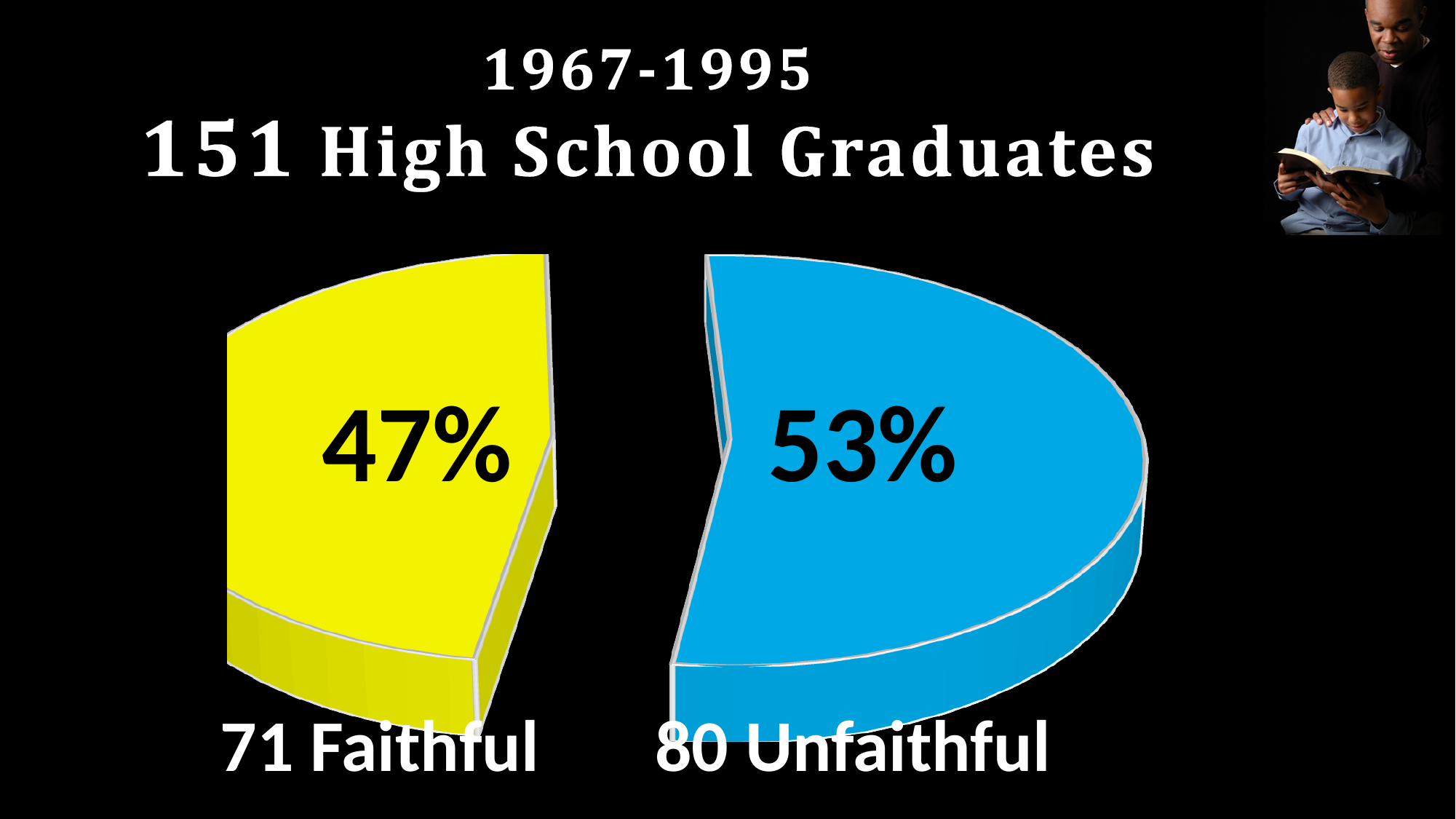
Which slice of the pie is larger, Faithful or Unfaithful? Unfaithful What is the total number of high school graduates stated in the chart title? 151 How many graduates are labelled as Unfaithful? 80 How many slices does the pie chart have? 2 What kind of chart is shown on the slide? Pie chart How many graduates are labelled as Faithful? 71 What is the difference in percentage points between the Unfaithful and Faithful slices? 6 Which category has the smallest share of the pie? Faithful What is the difference between the number of Unfaithful and Faithful graduates? 9 What percentage of the pie is labelled for the Faithful slice? 47% What colour is the Unfaithful slice of the pie? Blue What percentage of the pie is labelled for the Unfaithful slice? 53%